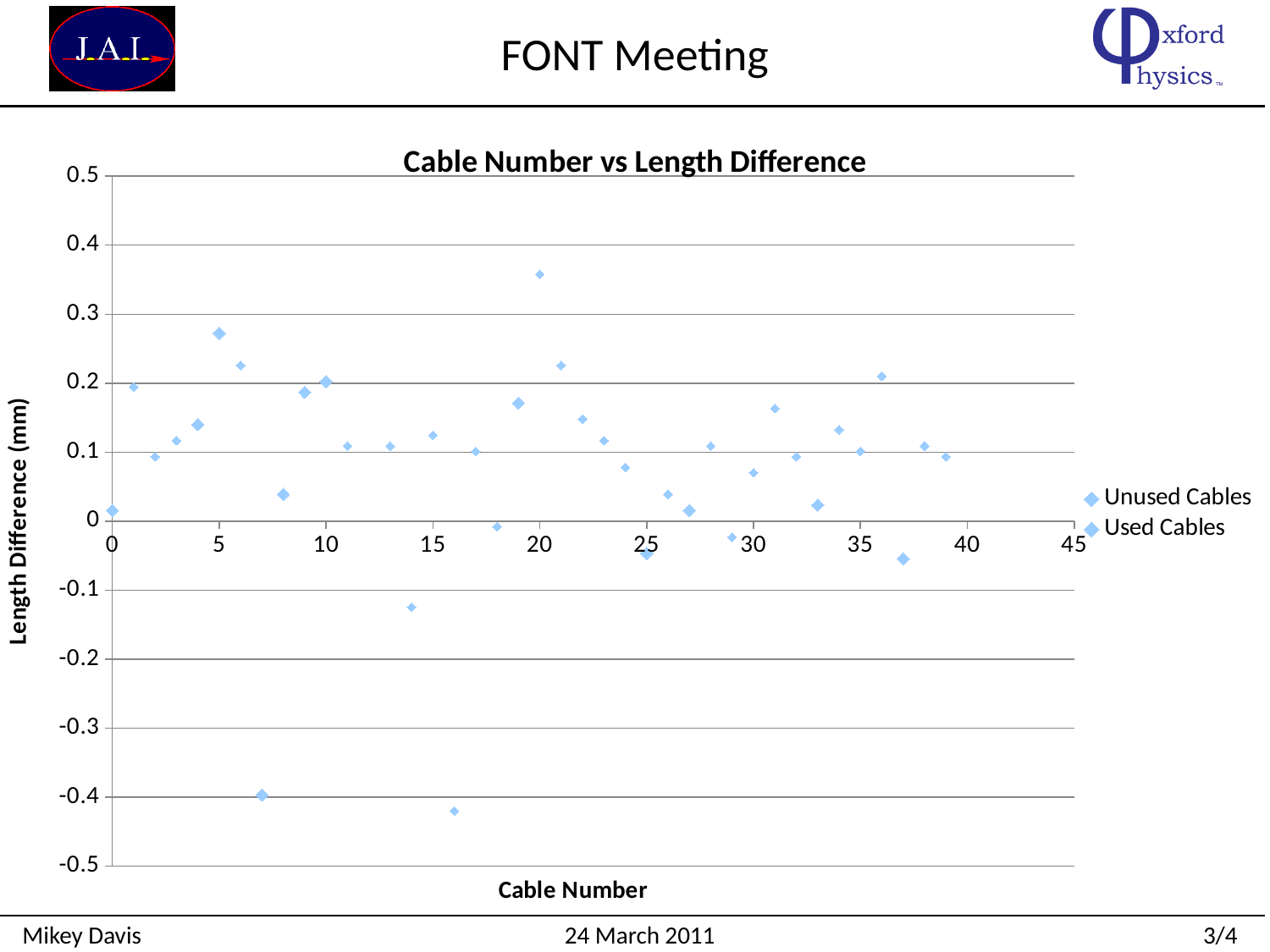
What is the label of the vertical axis? Length Difference (mm) Is the length difference for cable number 7 greater or less than -0.3? less Which has the larger length difference, cable number 5 or cable number 10? cable number 5 What is the title of the chart? Cable Number vs Length Difference Is the length difference for cable number 14 greater or less than -0.1? less Which cable number has the highest length difference? 20 What kind of chart is shown on the slide? scatter chart Is the length difference for cable number 16 greater or less than -0.4? less How many series does the chart legend list? 2 Which has the larger length difference, cable number 20 or cable number 21? cable number 20